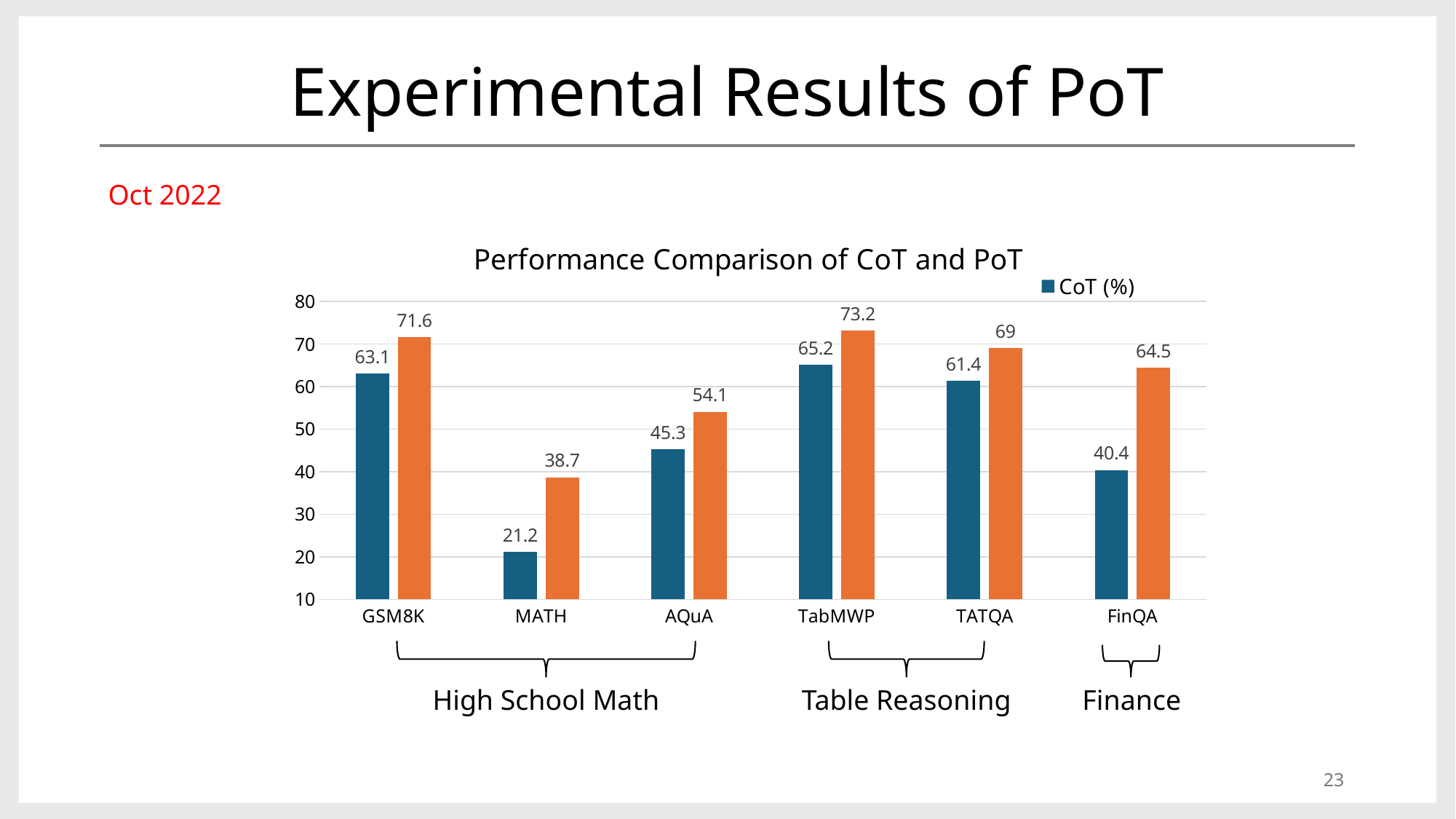
What is the title of the chart? Performance Comparison of CoT and PoT What value is labelled on the orange bar for FinQA? 64.5 What is the difference between the orange bar and the CoT (%) bar for FinQA? 24.1 What is the CoT (%) value for MATH? 21.2 Which category has the lowest CoT (%) value? MATH Which is larger, the CoT (%) value for AQuA or the CoT (%) value for TATQA? TATQA What value is labelled on the orange bar for TATQA? 69 Which category has the highest CoT (%) value? TabMWP What is the CoT (%) value for GSM8K? 63.1 How many categories are shown on the x axis? 6 What kind of chart is shown on the slide? Bar chart How many entries does the legend list? 1